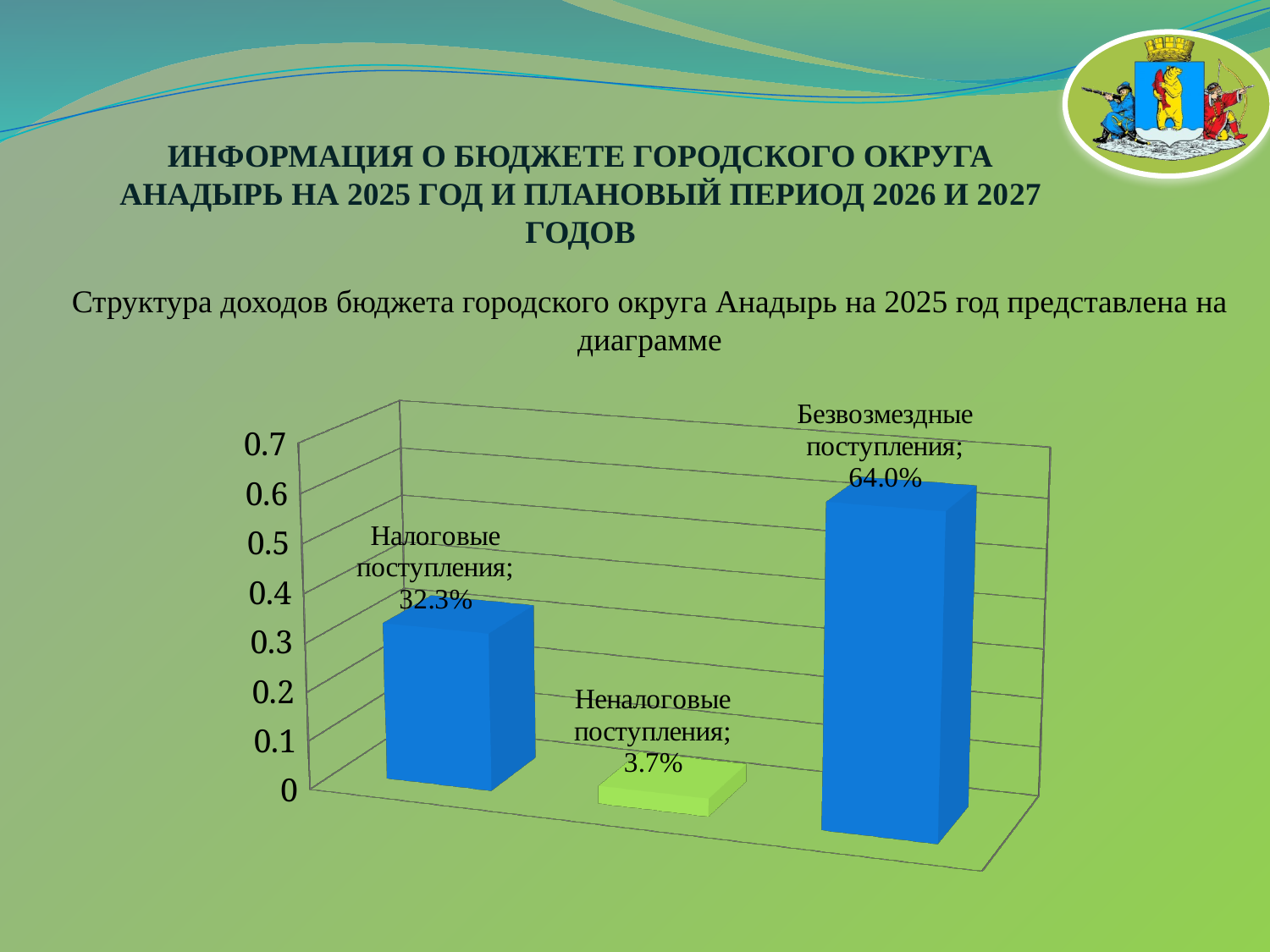
What is the value for Безвозмездные поступления? 64.0% What is the value for Неналоговые поступления? 3.7% What is the difference between Безвозмездные поступления and Налоговые поступления? 31.7% How many categories are shown in the chart? 3 Is the value for Налоговые поступления greater or less than 0.4? less What is the value for Налоговые поступления? 32.3% Is the value for Безвозмездные поступления greater or less than 0.6? greater Which is larger, Налоговые поступления or Безвозмездные поступления? Безвозмездные поступления Which category has the highest value? Безвозмездные поступления What kind of chart is shown on the slide? bar chart What is the difference between Налоговые поступления and Неналоговые поступления? 28.6% Which category has the lowest value? Неналоговые поступления